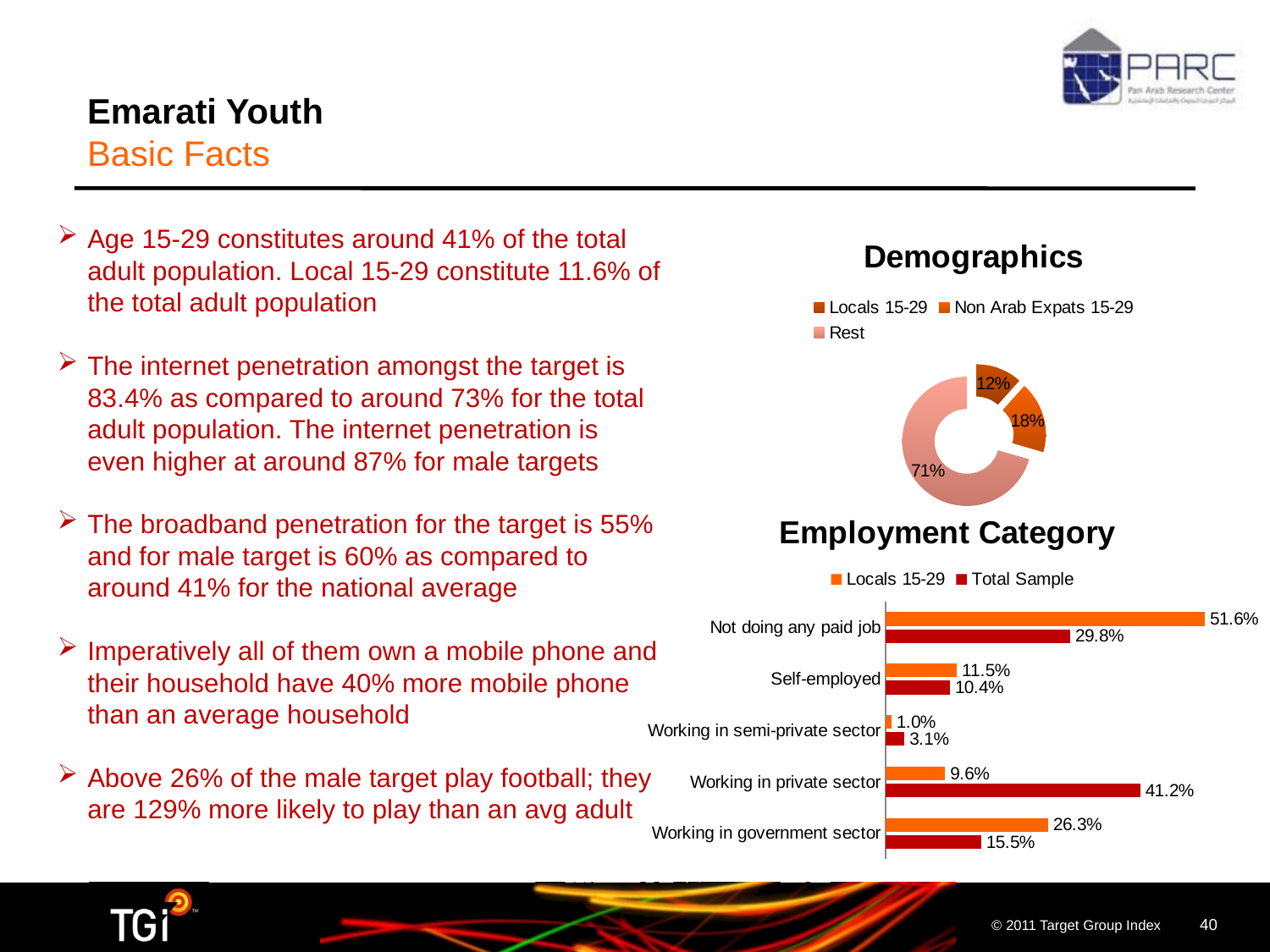
In the Employment Category chart, what is the Total Sample value for Working in private sector? 41.2% In the Demographics chart, what share is labelled for Locals 15-29? 12% In the Employment Category chart, what is the difference between the Locals 15-29 and Total Sample values for Working in government sector? 10.8% In the Employment Category chart, which is larger for Self-employed: Locals 15-29 or Total Sample? Locals 15-29 How many employment categories are shown in the Employment Category chart? 5 What kind of chart is the Demographics chart? Doughnut chart In the Demographics chart, which segment is the largest? Rest In the Employment Category chart, which category has the lowest Locals 15-29 value? Working in semi-private sector How many segments does the Demographics chart's legend list? 3 In the Demographics chart, what share is labelled for Rest? 71% What kind of chart is the Employment Category chart? Bar chart In the Employment Category chart, what is the value for Locals 15-29 for Not doing any paid job? 51.6%